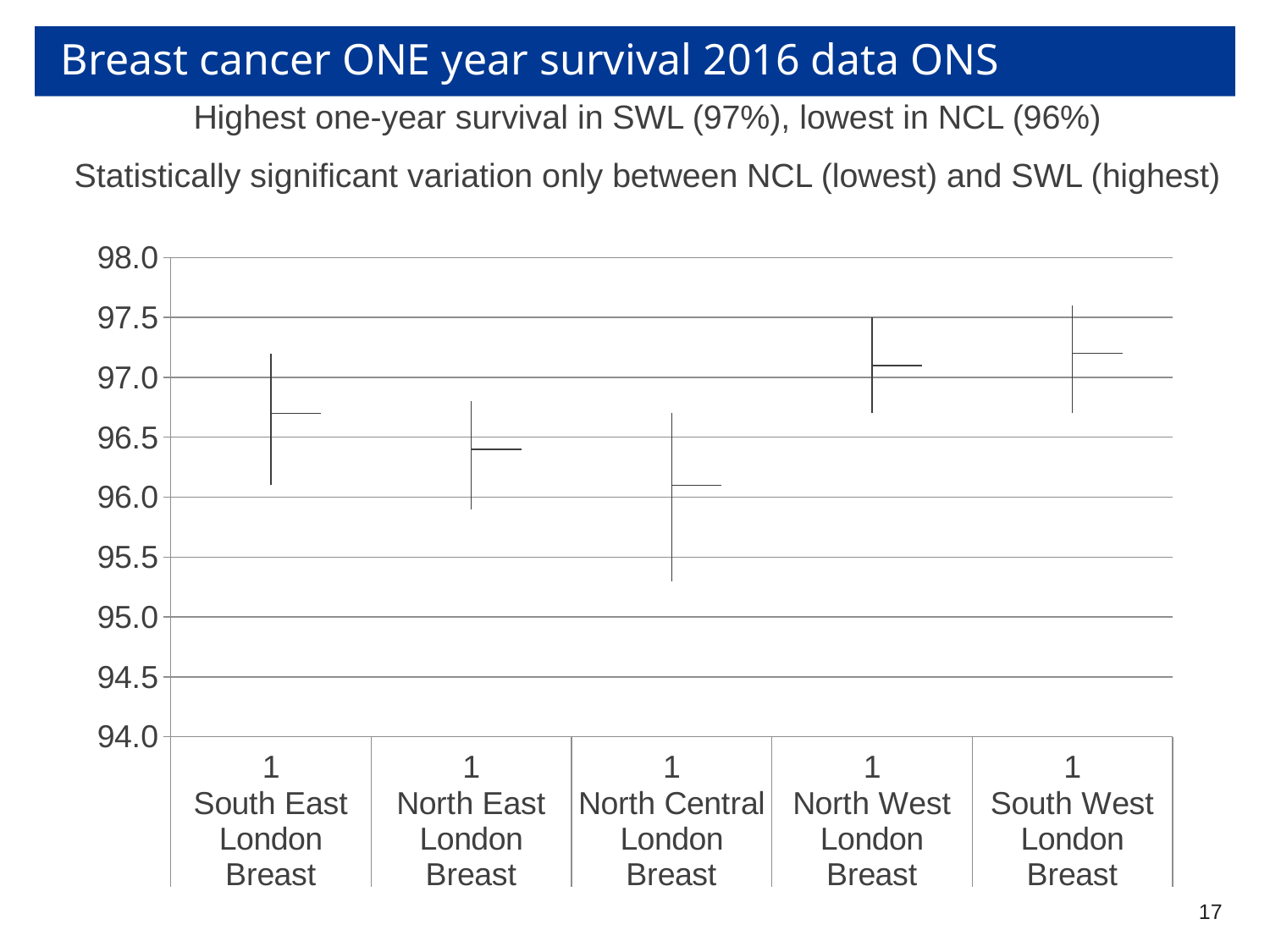
What is the highest value shown on the chart's vertical axis? 98.0 Is the value for South West London Breast greater or less than 97.0? greater Which area has the lowest one-year breast cancer survival on the chart? North Central London What is the title of the slide containing the chart? Breast cancer ONE year survival 2016 data ONS Is the value for South East London Breast greater or less than 96.5? greater Which is larger, the value for North East London Breast or North West London Breast? North West London Breast Which area has the highest one-year breast cancer survival on the chart? South West London Is the value for North Central London Breast greater or less than 96.5? less Which is larger, the value for South East London Breast or North Central London Breast? South East London Breast How many areas are plotted on the chart? 5